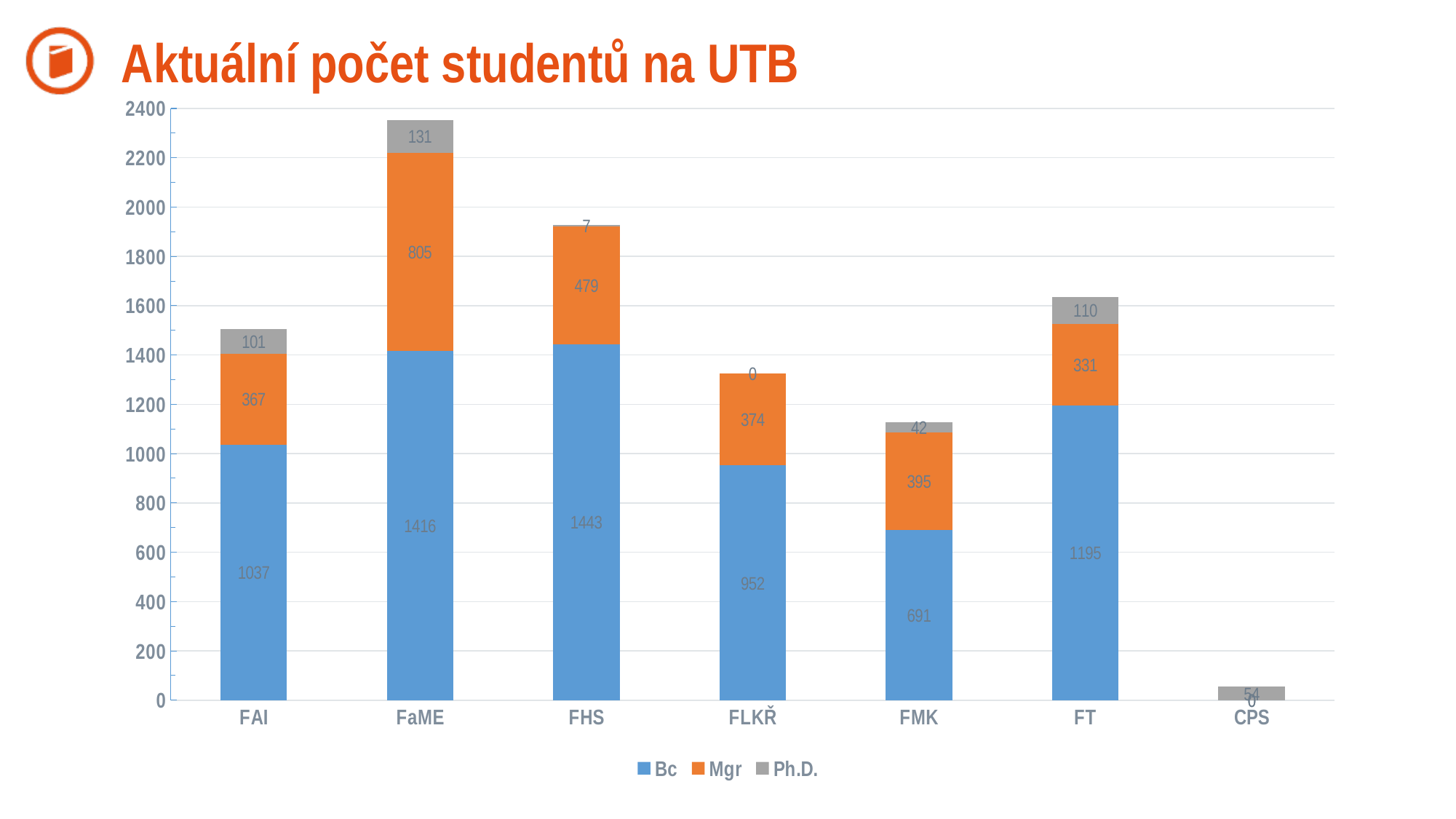
How many categories are shown on the x axis? 7 Which category has the lowest Bc value among FAI, FaME, FHS, FLKŘ, FMK and FT? FMK Which category has the highest Ph.D. value? FaME What is the Bc value for FHS? 1443 What is the total of the stacked bar for FAI? 1505 What is the Mgr value for FaME? 805 What is the Ph.D. value for FT? 110 Which is larger, the Bc value for FAI or the Bc value for FT? FT Is the total height of the FaME bar greater or less than 2200? greater What is the difference between the Mgr value for FaME and the Mgr value for FHS? 326 What kind of chart is shown on the slide? bar chart How many series does the legend list? 3